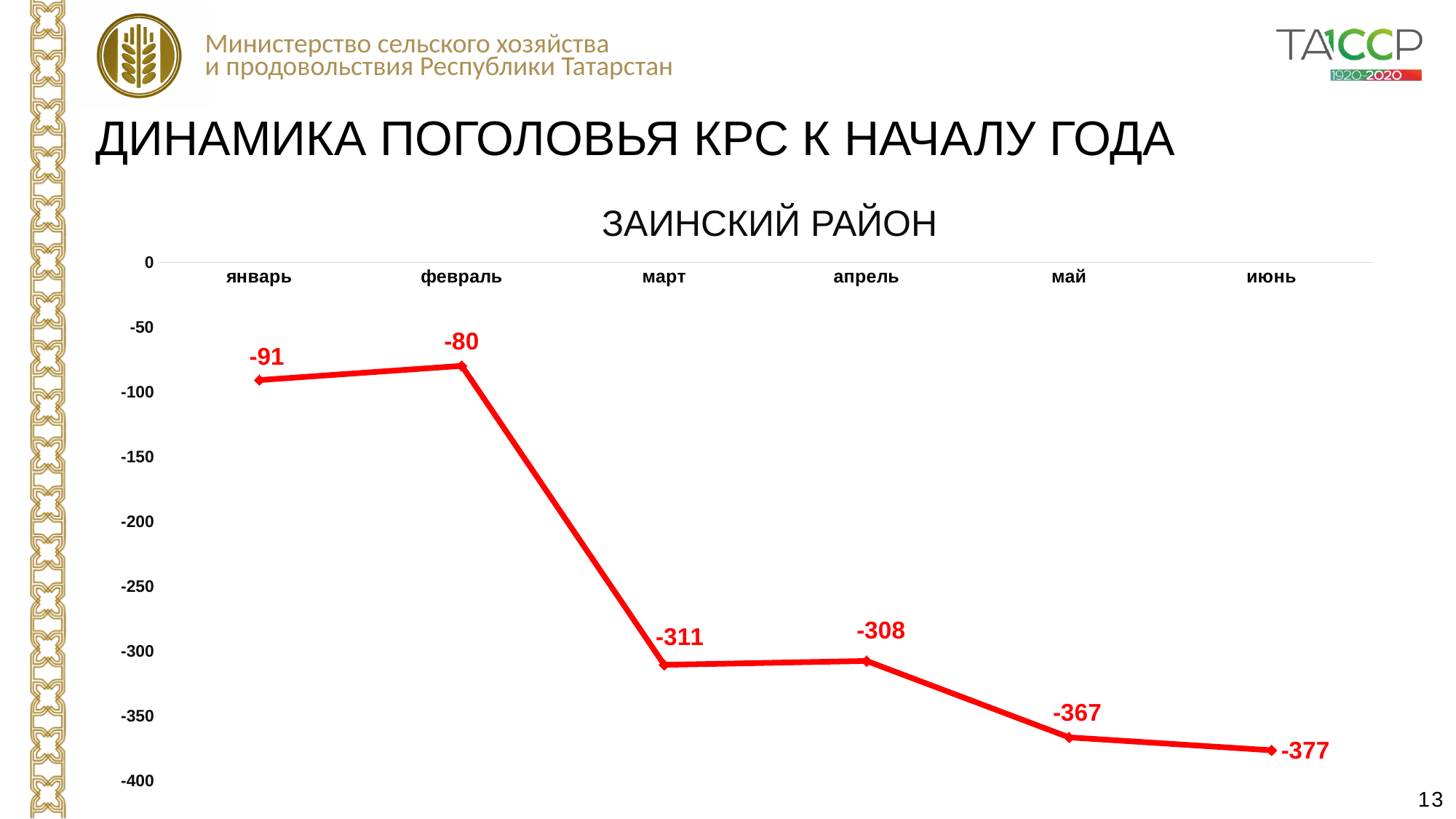
Which month has the lowest value on the chart? июнь Which month has the highest value on the chart? февраль What is the title of the chart? ЗАИНСКИЙ РАЙОН What kind of chart is shown on the slide? line chart What is the difference between the values for январь and февраль? 11 What is the value for февраль (February) on the chart? -80 How many months are plotted on the chart? 6 What is the value for март (March) on the chart? -311 Do the values generally rise or fall from январь to июнь? fall Which is larger, the value for март or the value for апрель? апрель What is the difference between the values for май and июнь? 10 What is the value for июнь (June) on the chart? -377